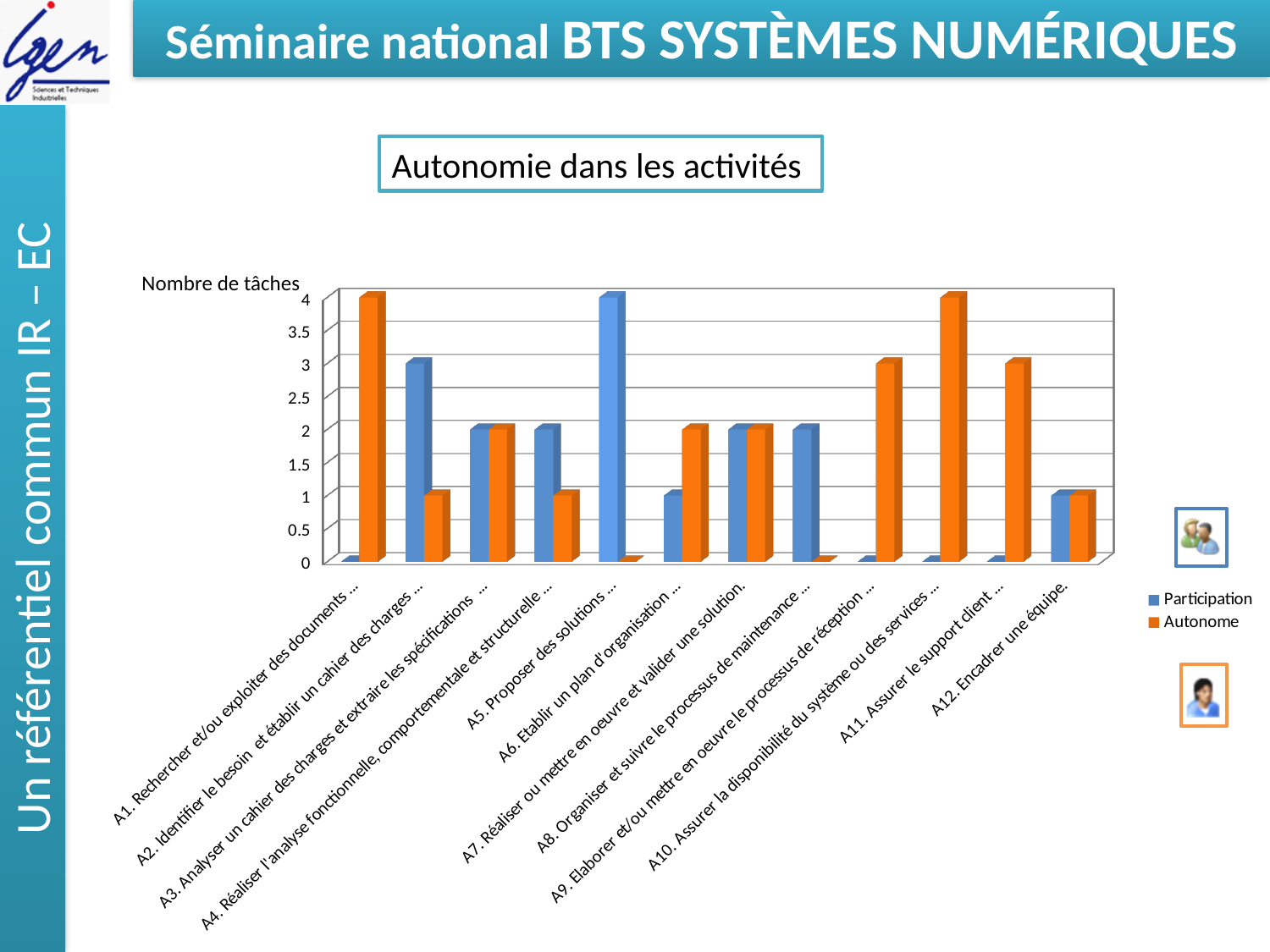
How many activity categories (A1 to A12) are plotted on the x axis? 12 How many series does the legend list? 2 What is the Participation value for A2. Identifier le besoin et établir un cahier des charges? 3 For A2, which is larger: Participation or Autonome? Participation What is the difference between the Participation and Autonome values for A2? 2 What is the Participation value for A5. Proposer des solutions? 4 What is the Autonome value for A12. Encadrer une équipe? 1 What is the Autonome value for A1. Rechercher et/ou exploiter des documents? 4 What kind of chart is shown on the slide? bar chart Which colour represents the Autonome series in the legend? orange Which category has the highest Participation value? A5. Proposer des solutions